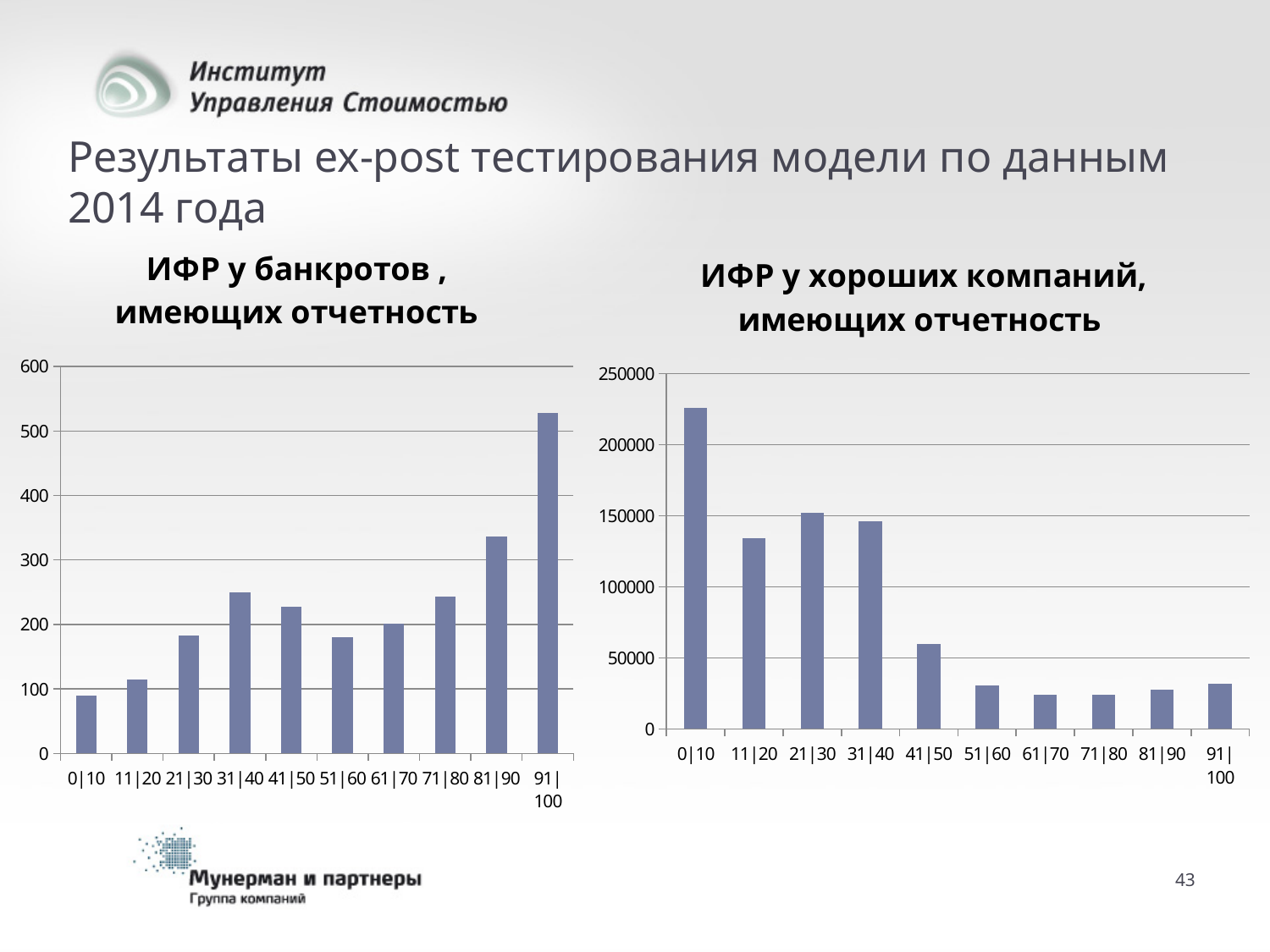
What kind of chart is the chart titled 'ИФР у хороших компаний, имеющих отчетность'? Bar chart In the chart titled 'ИФР у банкротов, имеющих отчетность', which category has the highest value? 91|100 In the chart titled 'ИФР у хороших компаний, имеющих отчетность', is the value for 41|50 greater or less than 100000? less In the chart titled 'ИФР у банкротов, имеющих отчетность', is the value for 91|100 greater or less than 500? greater In the chart titled 'ИФР у банкротов, имеющих отчетность', is the value for 0|10 greater or less than 100? less How many categories are shown on the x axis of the chart titled 'ИФР у банкротов, имеющих отчетность'? 10 In the chart titled 'ИФР у банкротов, имеющих отчетность', which category has the lowest value? 0|10 In the chart titled 'ИФР у хороших компаний, имеющих отчетность', which is larger, the value for 21|30 or the value for 11|20? 21|30 In the chart titled 'ИФР у банкротов, имеющих отчетность', which is larger, the value for 31|40 or the value for 51|60? 31|40 In the chart titled 'ИФР у хороших компаний, имеющих отчетность', which category has the highest value? 0|10 What is the title of the chart on the left side of the slide? ИФР у банкротов, имеющих отчетность